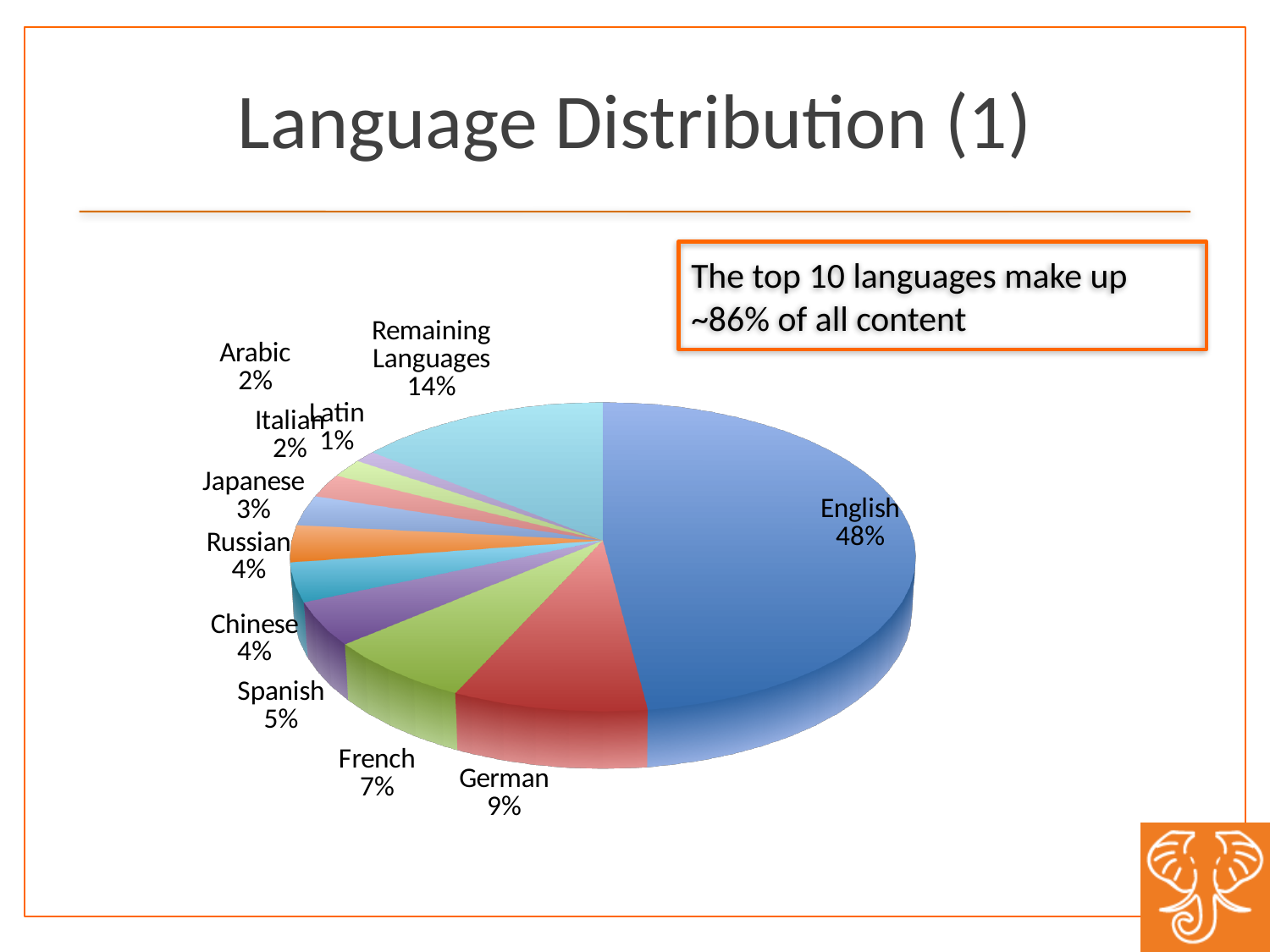
What is the value shown for German? 9% What kind of chart is shown on the slide? pie chart What is the value shown for Japanese? 3% Which slice of the pie is the largest? English How many slices does the pie chart have? 11 What share of the pie does English account for? 48% What is the title of the slide containing the pie chart? Language Distribution (1) What is the difference between the shares for French and Spanish? 2% Which is larger, the share for French or the share for Chinese? French What is the difference between the shares for English and German? 39% Which language has the smallest slice of the pie? Latin What is the value shown for Remaining Languages? 14%